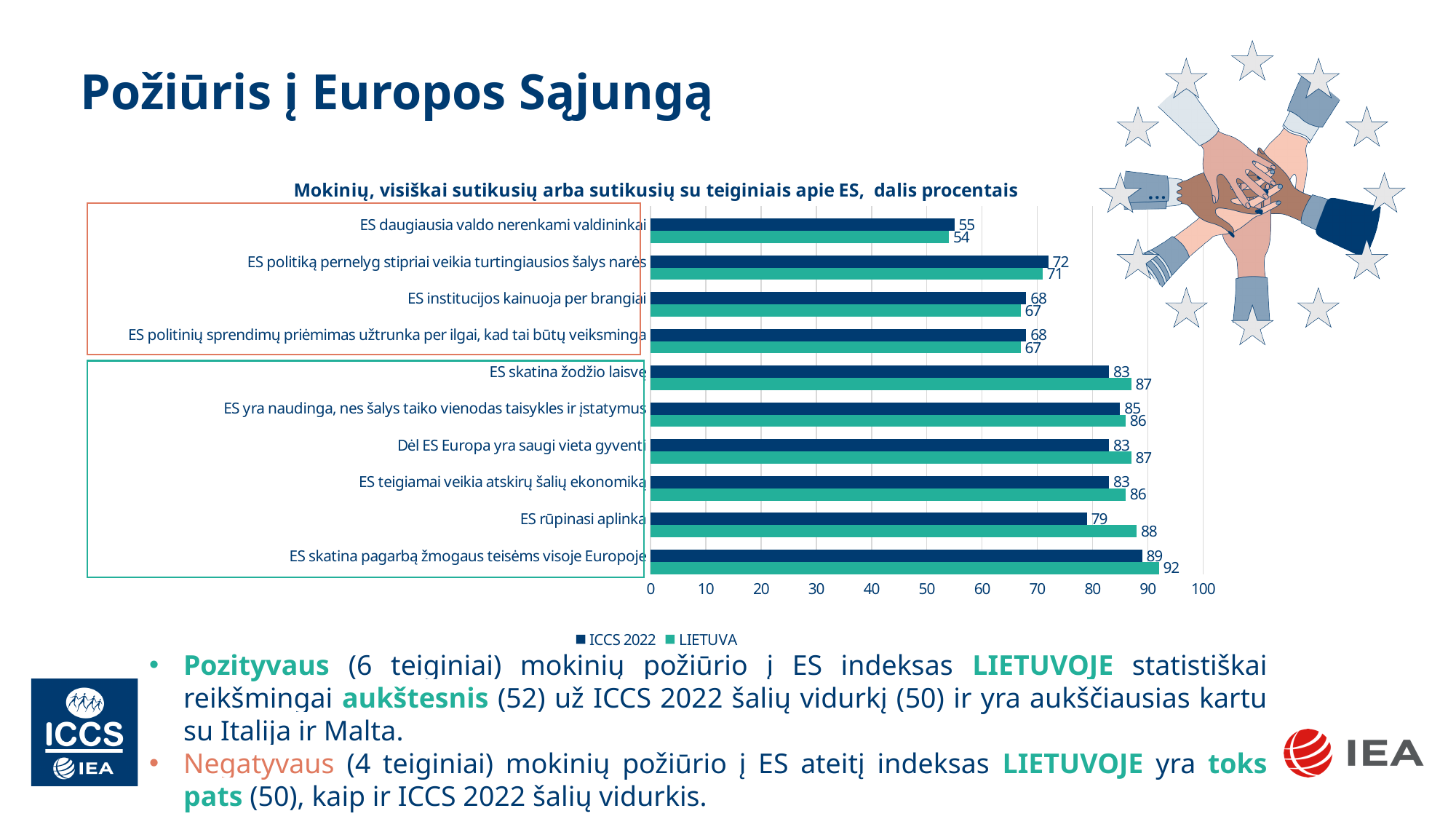
Which statement has the lowest ICCS 2022 value? ES daugiausia valdo nerenkami valdininkai Is the ICCS 2022 value for "ES politiką pernelyg stipriai veikia turtingiausios šalys narės" greater or less than 60? greater What is the LIETUVA value for "ES daugiausia valdo nerenkami valdininkai"? 54 What is the LIETUVA value for "ES skatina žodžio laisvę"? 87 How many statements (categories) are shown in the chart? 10 What is the difference between the LIETUVA and ICCS 2022 values for "ES rūpinasi aplinka"? 9 What is the title of the chart? Mokinių, visiškai sutikusių arba sutikusių su teiginiais apie ES, dalis procentais Which statement has the highest LIETUVA value? ES skatina pagarbą žmogaus teisėms visoje Europoje What is the ICCS 2022 value for "ES rūpinasi aplinka"? 79 How many series does the legend list? 2 For "ES skatina pagarbą žmogaus teisėms visoje Europoje", which is larger: the ICCS 2022 value or the LIETUVA value? LIETUVA What kind of chart is shown on the slide? Bar chart